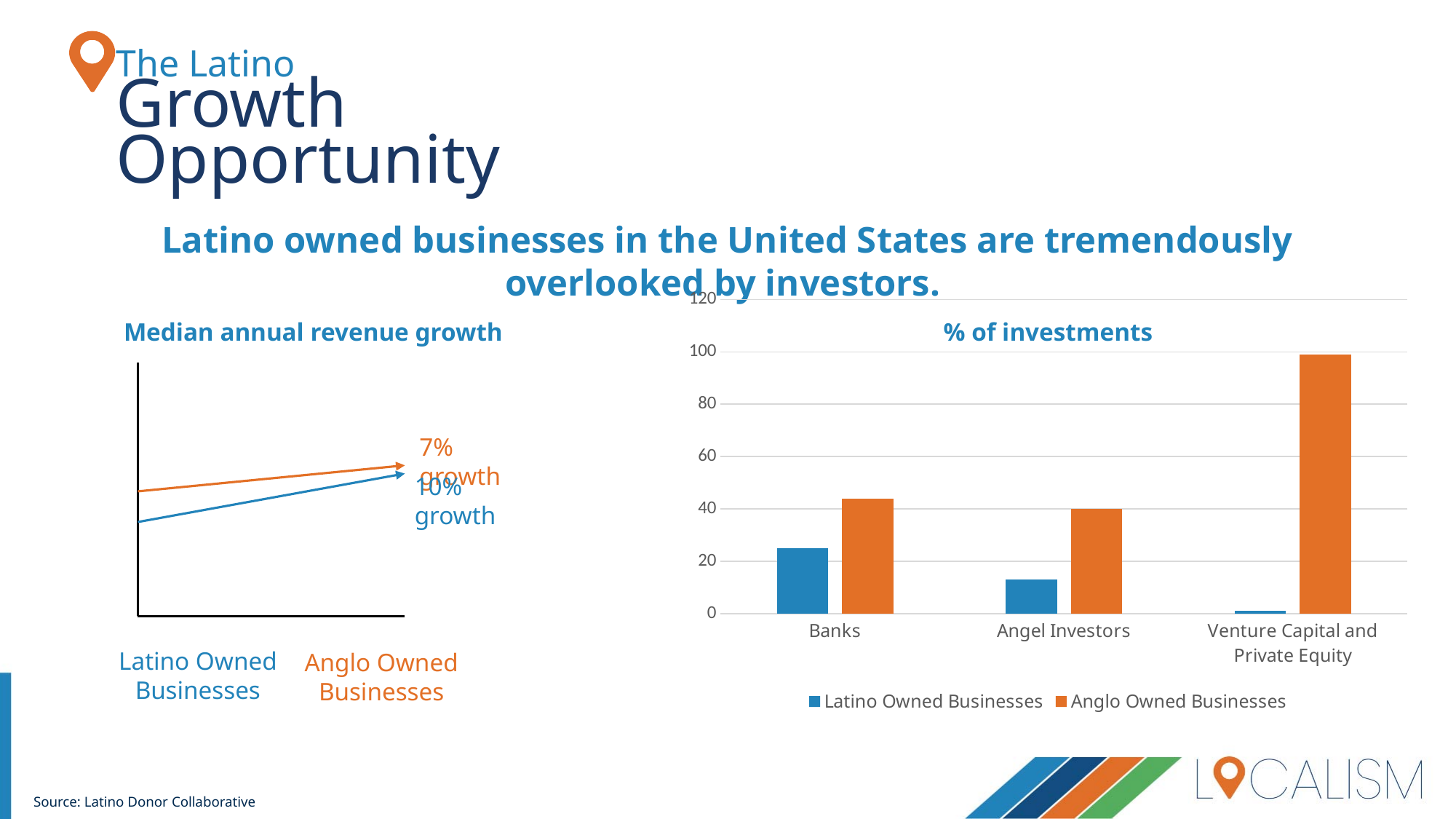
In the 'Median annual revenue growth' chart, what is the growth for Latino Owned Businesses? 10% In the '% of investments' chart, which category has the highest value for Anglo Owned Businesses? Venture Capital and Private Equity In the '% of investments' chart, which is larger at Banks: Latino Owned Businesses or Anglo Owned Businesses? Anglo Owned Businesses In the '% of investments' chart, is the value for Latino Owned Businesses at Angel Investors greater or less than 20? less In the '% of investments' chart, which category has the lowest value for Latino Owned Businesses? Venture Capital and Private Equity In the 'Median annual revenue growth' chart, what is the growth for Anglo Owned Businesses? 7% In the '% of investments' chart, is the value for Anglo Owned Businesses at Venture Capital and Private Equity greater or less than 80? greater In the 'Median annual revenue growth' chart, which has higher growth: Latino Owned Businesses or Anglo Owned Businesses? Latino Owned Businesses In the '% of investments' chart, how many series does the legend list? 2 In the '% of investments' chart, how many categories are shown on the x axis? 3 What kind of chart is the '% of investments' chart? bar chart In the '% of investments' chart, is the value for Latino Owned Businesses at Banks greater or less than 20? greater